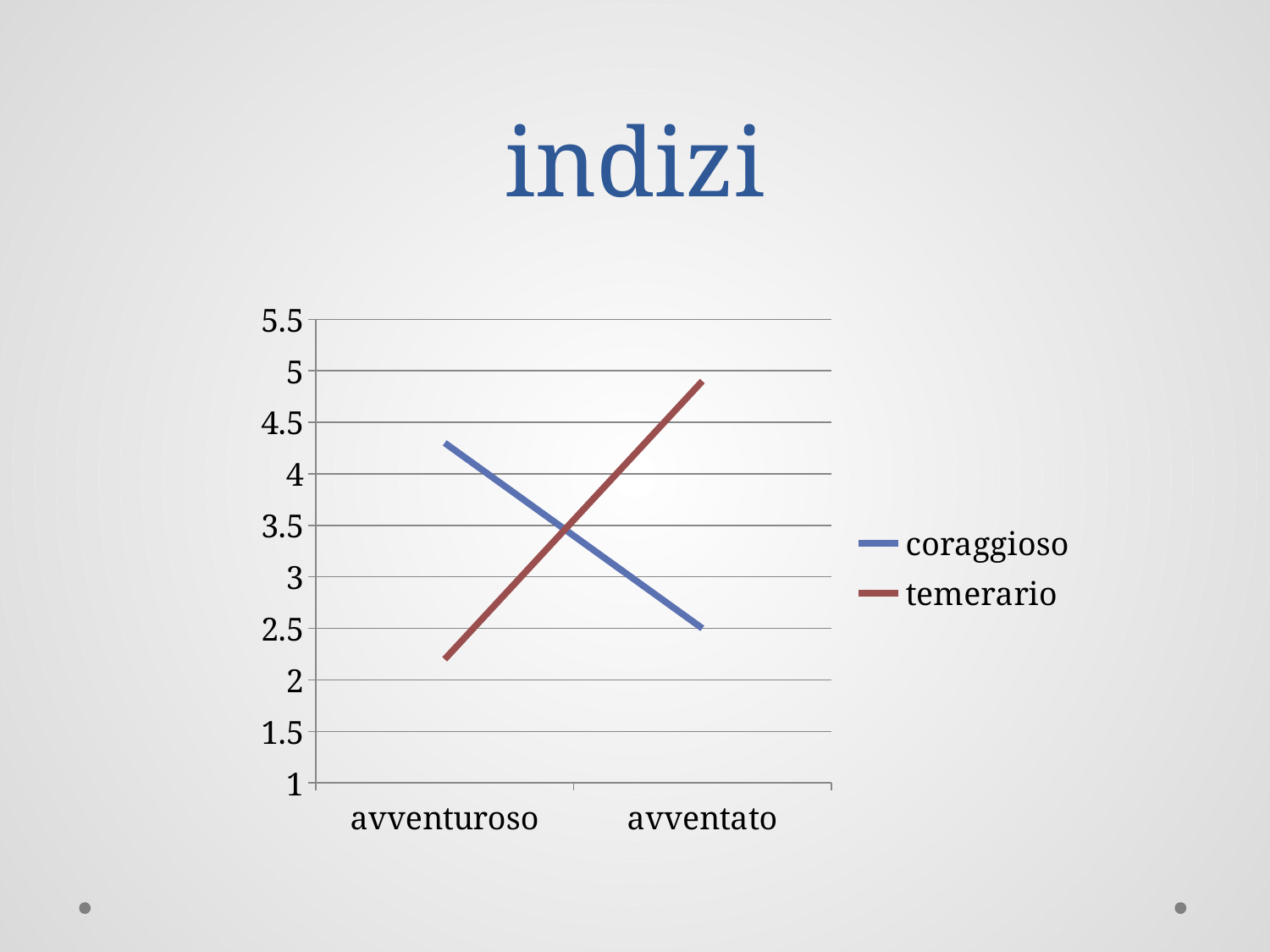
What kind of chart is shown on the slide? line chart How many categories are shown on the x axis? 2 At avventuroso, which series has the higher value, coraggioso or temerario? coraggioso Is the value for temerario at avventato greater or less than 4.5? greater How many series does the legend list? 2 Does the coraggioso line rise or fall from avventuroso to avventato? fall Is the value for coraggioso at avventato greater or less than 3? less At avventato, which series has the higher value, coraggioso or temerario? temerario Which colour is the coraggioso line? blue Is the value for temerario at avventuroso greater or less than 2.5? less What is the title of the chart? indizi